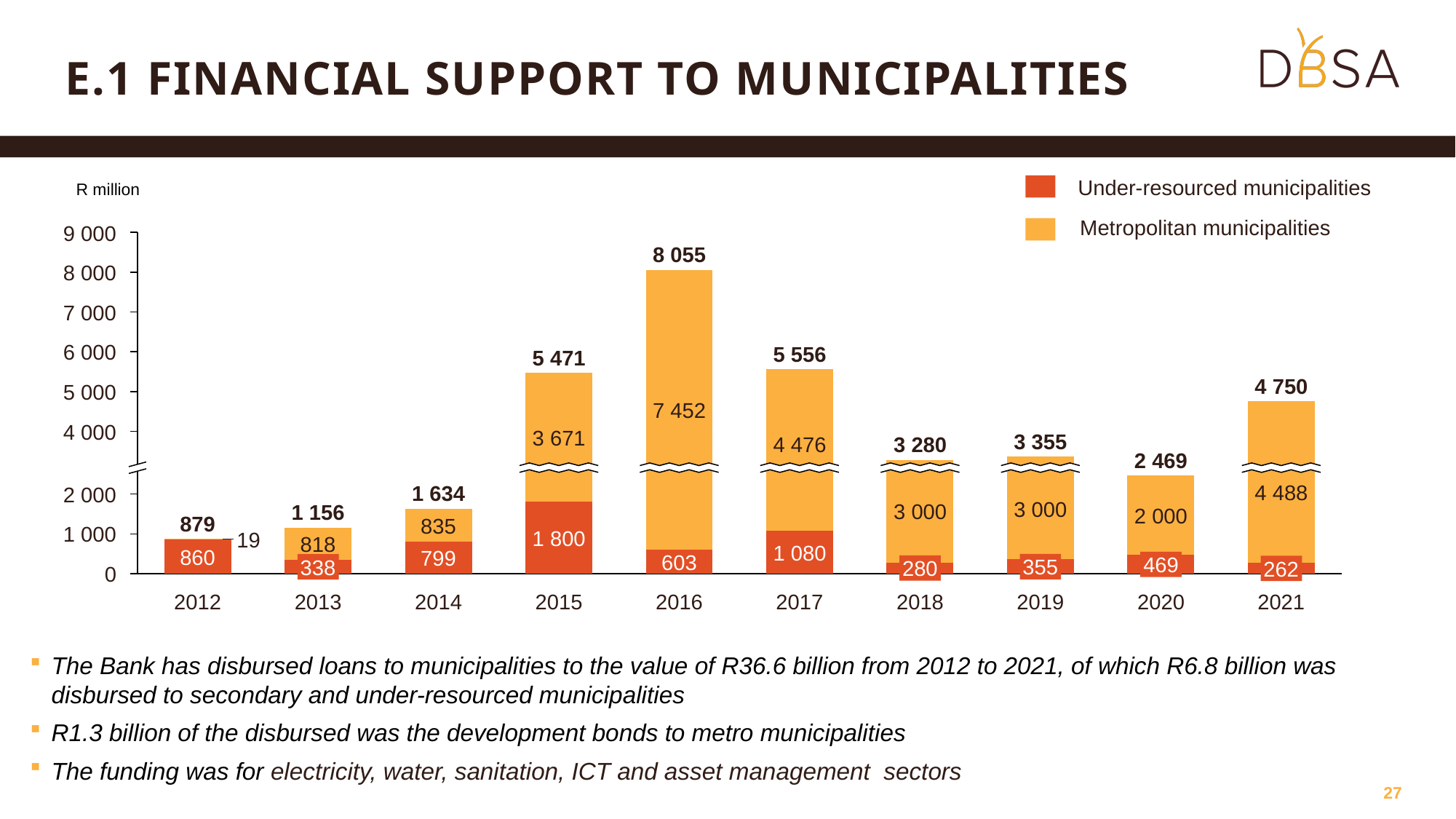
Which is larger, the Under-resourced municipalities value in 2017 or in 2020? 2017 Which year has the lowest total? 2012 How many years are shown on the x axis? 10 What is the value for Under-resourced municipalities in 2015? 1 800 What is the total value for 2016? 8 055 What is the value for Metropolitan municipalities in 2021? 4 488 What unit is shown above the y axis of the chart? R million What is the difference between the Metropolitan municipalities value in 2016 and in 2017? 2 976 What kind of chart is shown on the slide? Stacked bar chart Do the totals rise or fall from 2018 to 2020? Rise then fall Which year has the highest total? 2016 How many series does the legend list? 2